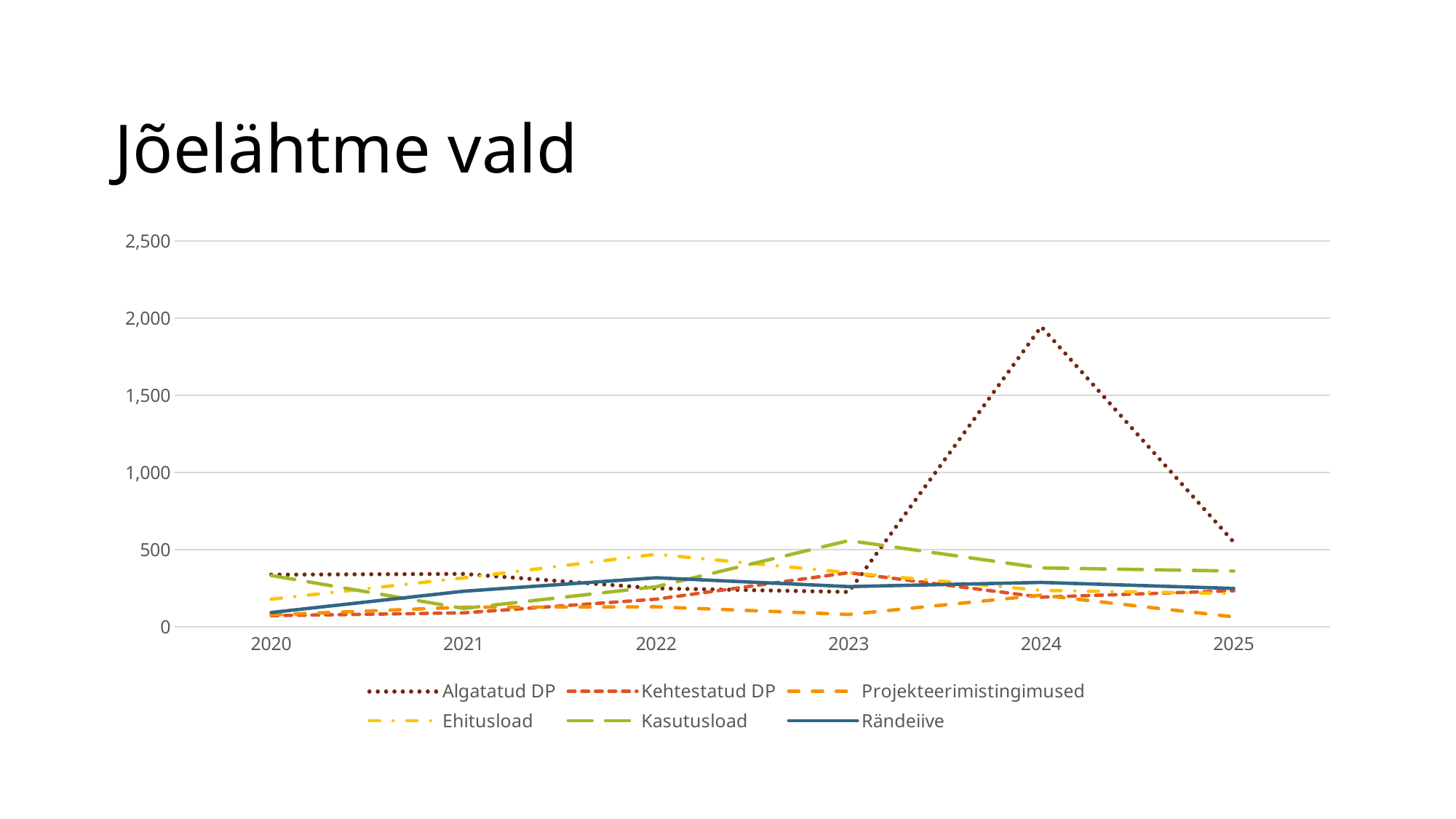
Is the value for Algatatud DP in 2024 greater or less than 1,500? greater Is the value for Algatatud DP in 2025 greater or less than 1,000? less Which is larger in 2024: Algatatud DP or Kasutusload? Algatatud DP What is the title of the slide containing the chart? Jõelähtme vald How many years are shown along the x axis? 6 Is the value for Kasutusload in 2023 greater or less than 500? greater In which year does the Algatatud DP series reach its highest value? 2024 What kind of chart is shown on the slide? line chart Does the Rändeiive series rise or fall from 2020 to 2022? rise How many series does the legend list? 6 Which series reaches the highest value anywhere on the chart? Algatatud DP